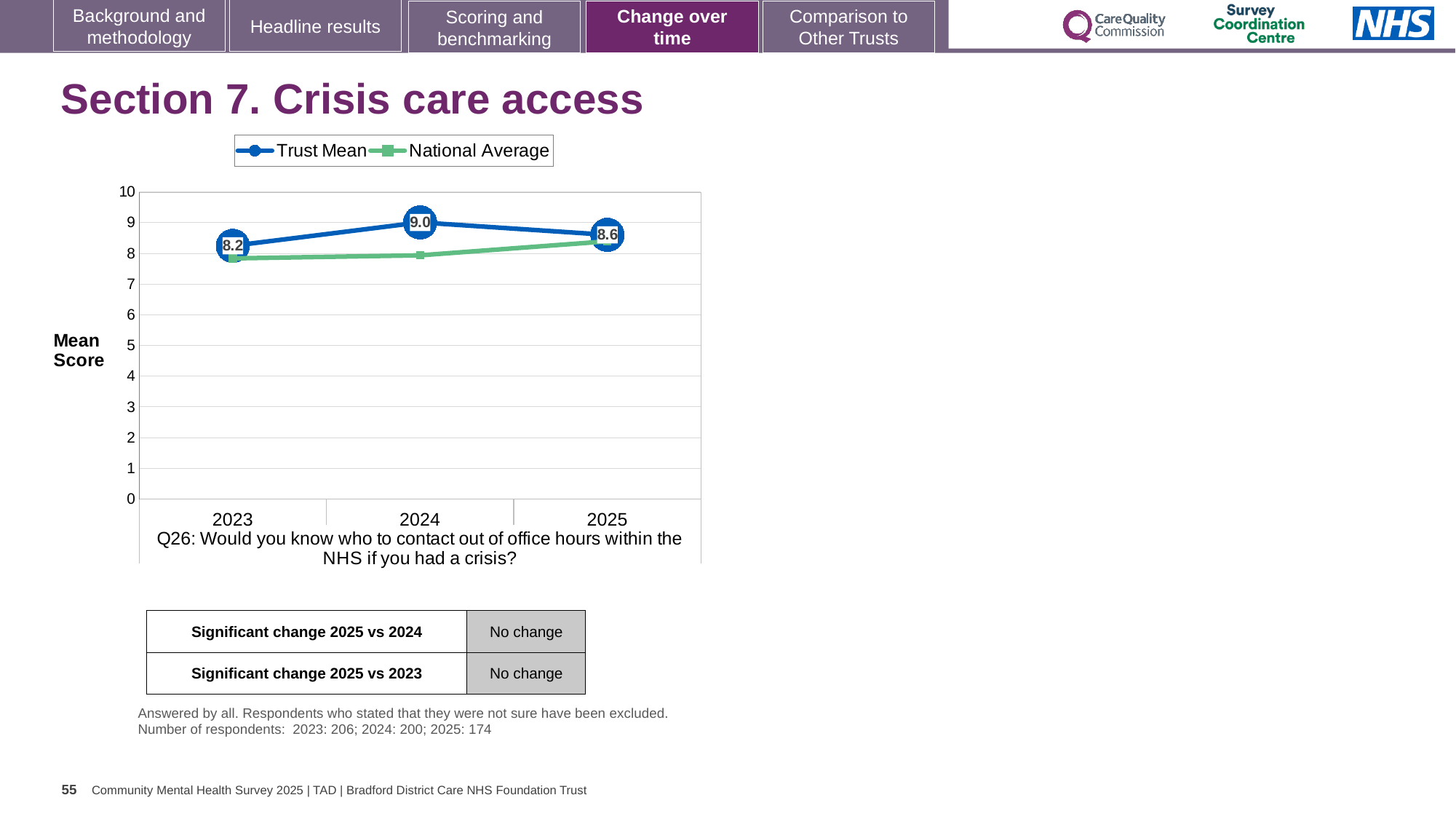
How many series does the legend list? 2 What is the Trust Mean value for 2023? 8.2 What is the difference between the Trust Mean in 2024 and in 2023? 0.8 In which year is the Trust Mean highest? 2024 Is the National Average value for 2023 greater or less than 8? less What is the Trust Mean value for 2025? 8.6 What kind of chart is shown on the slide? Line chart How many years are plotted on the x axis? 3 What is the Trust Mean value for 2024? 9.0 Does the Trust Mean rise or fall from 2024 to 2025? Fall In 2024, which is larger: the Trust Mean or the National Average? Trust Mean In which year is the Trust Mean lowest? 2023